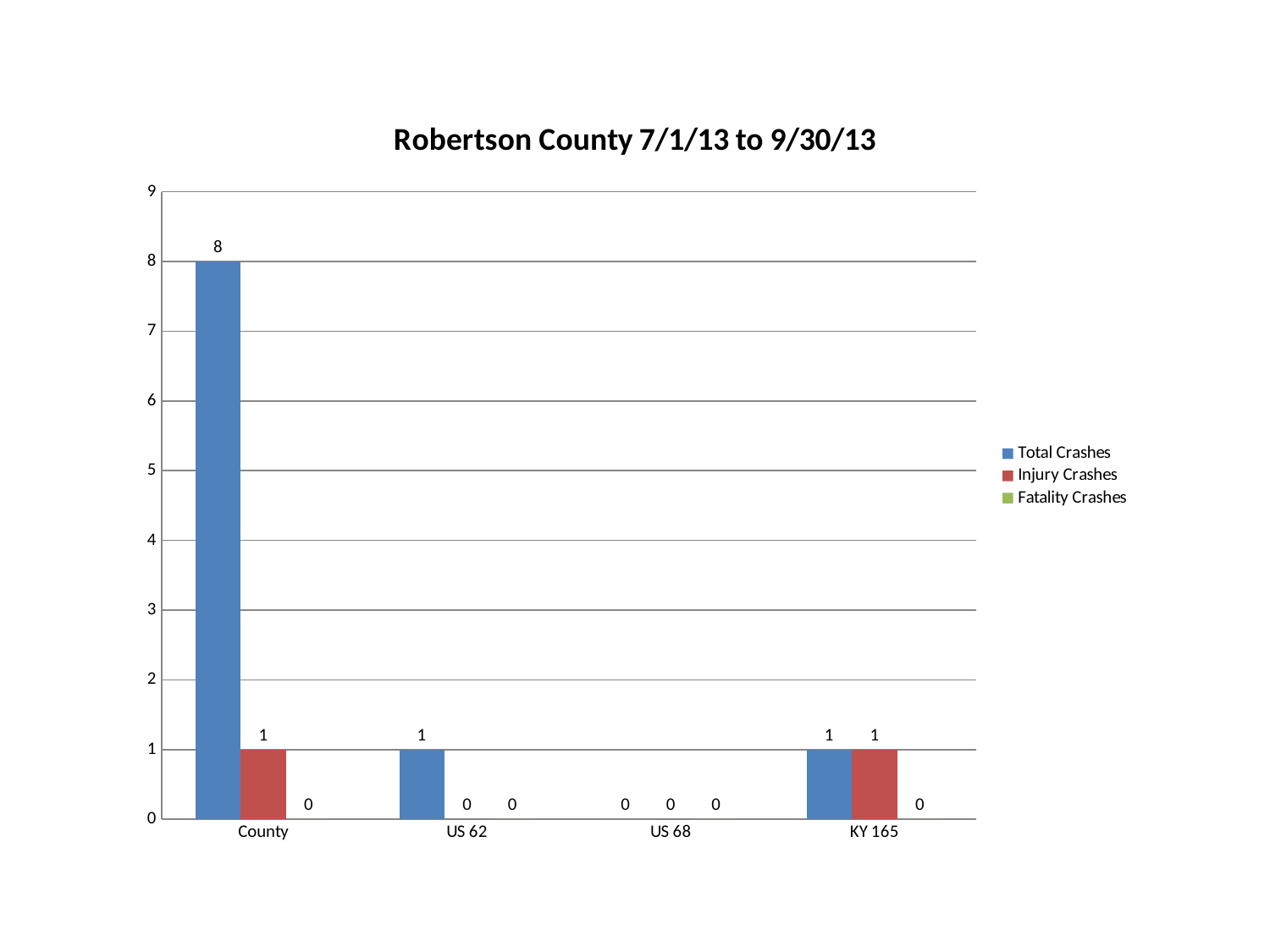
How many series does the legend list? 3 Which category has the lowest Total Crashes? US 68 Which is larger, Total Crashes for County or Total Crashes for US 62? Total Crashes for County What is the value of Total Crashes for County? 8 What is the value of Fatality Crashes for County? 0 What is the title of the chart? Robertson County 7/1/13 to 9/30/13 What is the value of Injury Crashes for KY 165? 1 How many categories are shown on the x axis? 4 What is the value of Total Crashes for US 68? 0 Which category has the highest Total Crashes? County What is the difference between Total Crashes and Injury Crashes for County? 7 What kind of chart is shown on the slide? Bar chart